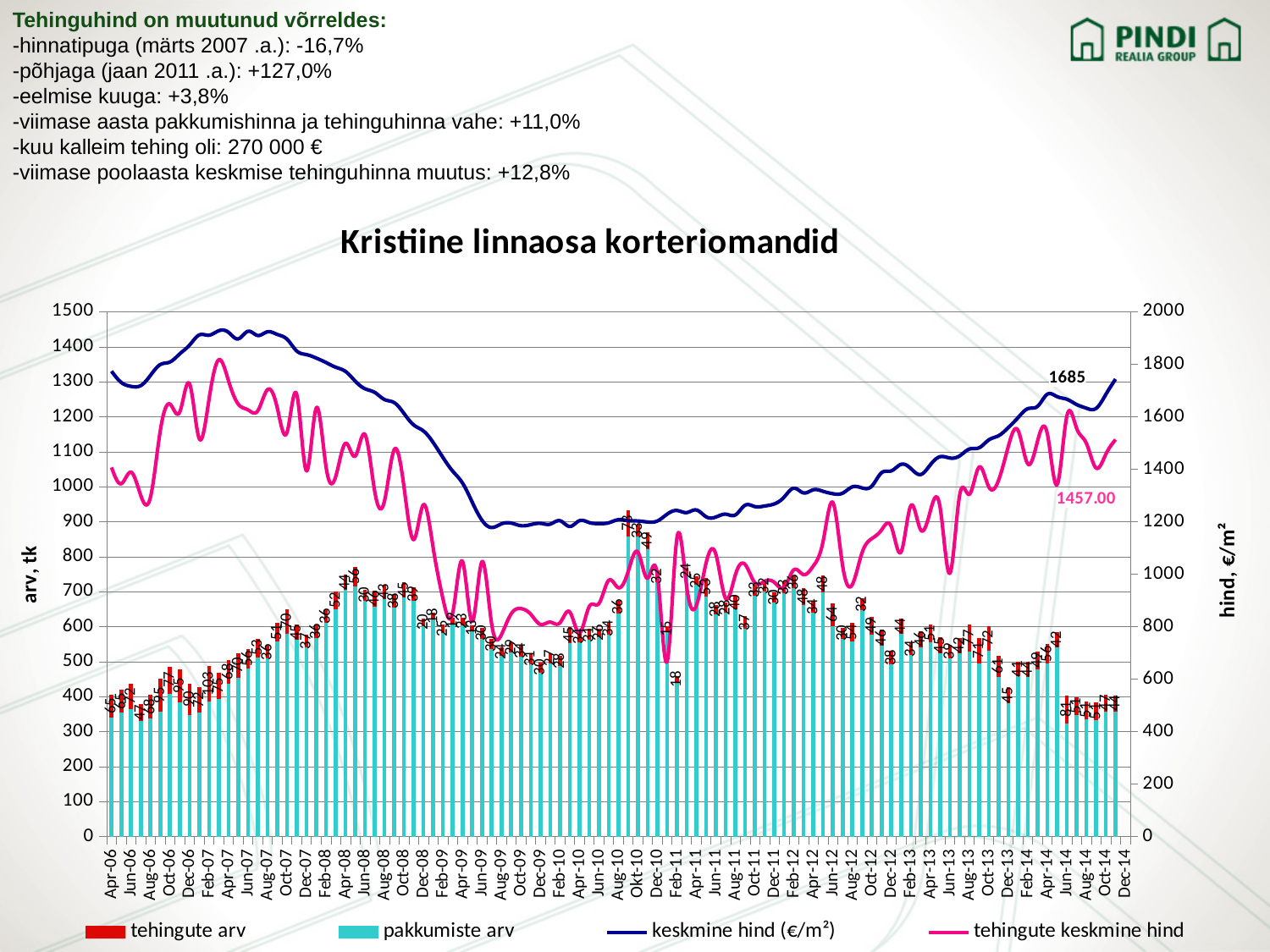
How many series does the chart legend list? 4 Is the pakkumiste arv value for Apr-06 greater or less than 500? less What is the title of the chart? Kristiine linnaosa korteriomandid Does the keskmine hind (€/m²) line rise or fall between Jan-11 and Dec-14? rise What is the difference between the labelled values 1685 (keskmine hind) and 1457.00 (tehingute keskmine hind)? 228 Which is larger at the end of the chart: the labelled keskmine hind value or the labelled tehingute keskmine hind value? keskmine hind (1685) In which year does the keskmine hind (€/m²) line reach its highest point? 2007 What is the last labelled value of the tehingute keskmine hind line? 1457.00 What is the last labelled value of the keskmine hind (€/m²) line? 1685 Is the pakkumiste arv value for Apr-08 greater or less than 600? greater What kind of chart is shown on the slide? Combined bar and line chart Which series is drawn as a dark blue line? keskmine hind (€/m²)